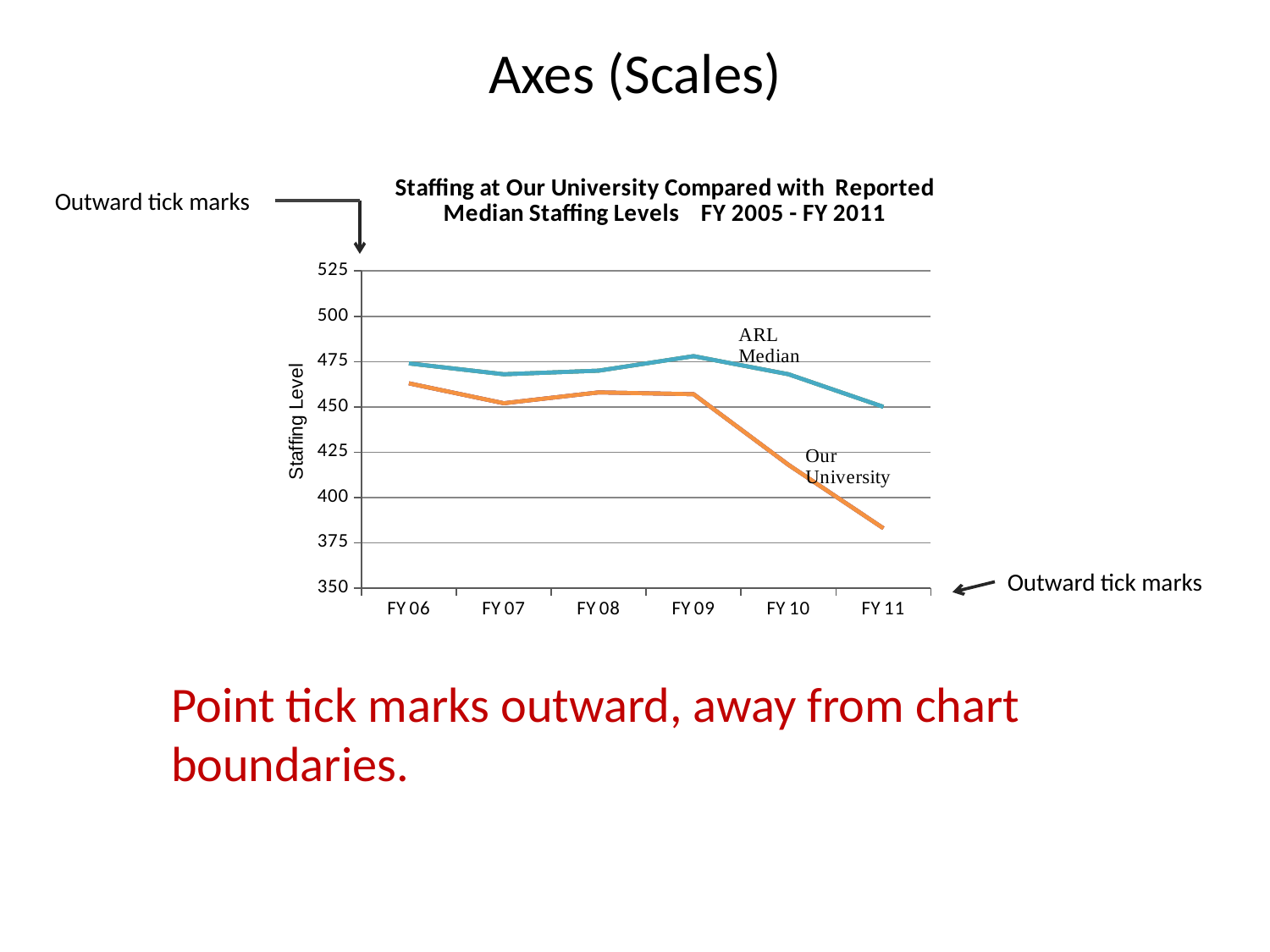
In which fiscal year is the Our University series at its lowest? FY 11 Is the value for Our University in FY 11 greater or less than 400? less In FY 11, which series has the larger value, ARL Median or Our University? ARL Median What is the title of the vertical axis of the chart? Staffing Level Is the value for Our University in FY 10 greater or less than 450? less Does the Our University series rise or fall from FY 09 to FY 11? fall How many data series are plotted in the chart? 2 How many fiscal years are plotted along the x axis of the chart? 6 What kind of chart is shown on the slide? line chart Is the value for Our University in FY 06 greater or less than 450? greater In which fiscal year is the ARL Median series at its lowest? FY 11